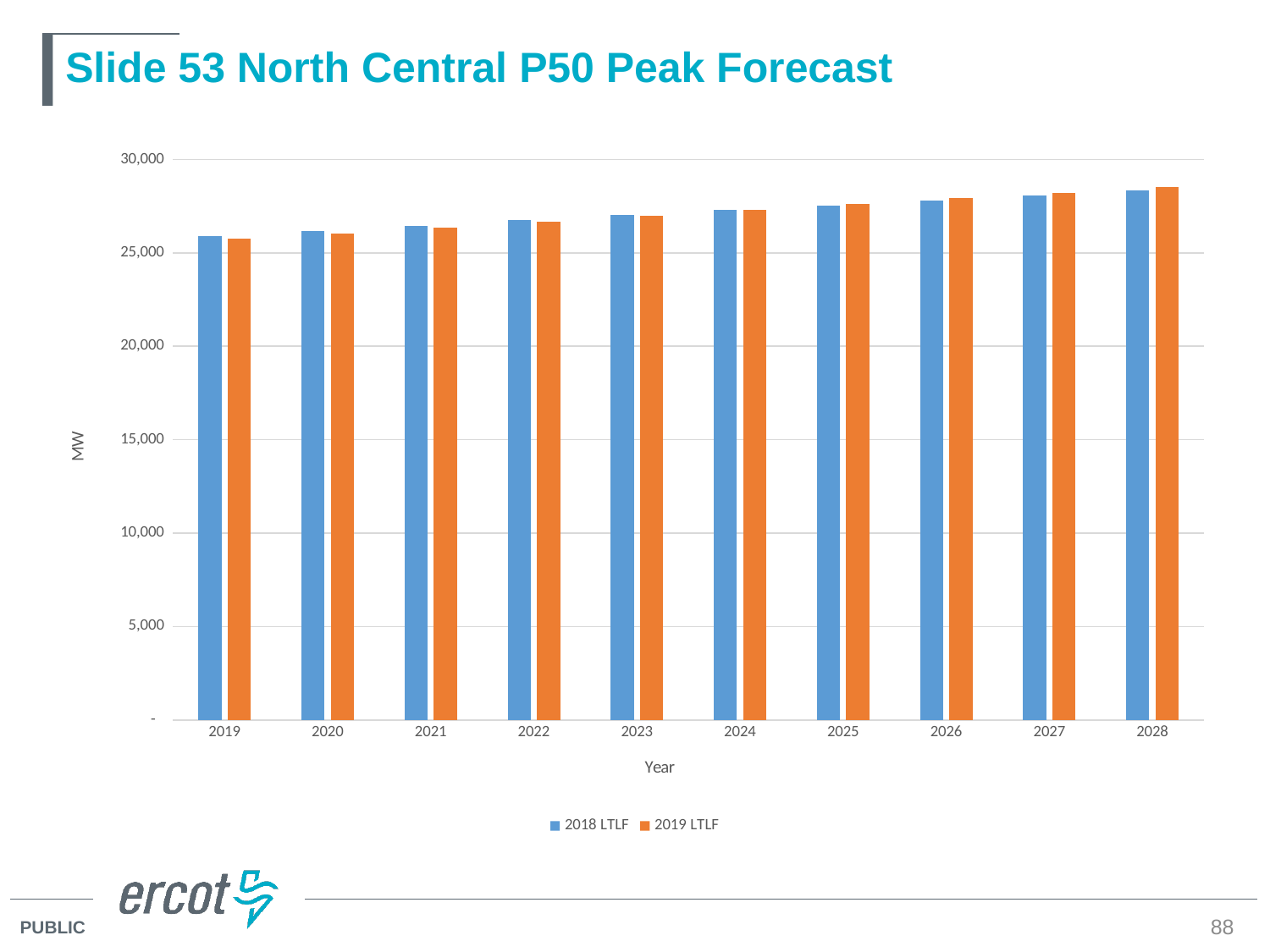
Do the 2018 LTLF values rise or fall across the years shown? Rise What kind of chart is shown on the slide? Bar chart How many series does the legend list? 2 Is the 2019 LTLF value for 2028 greater or less than 30,000? less Is the 2018 LTLF value for 2019 greater or less than 25,000? greater What is the label on the vertical axis? MW Which colour represents the 2019 LTLF series? Orange Which year has the lowest 2018 LTLF value? 2019 Which year has the highest 2019 LTLF value? 2028 How many years are shown on the x axis? 10 Do the 2019 LTLF values rise or fall from 2019 to 2028? Rise Is the 2019 LTLF value for 2024 greater or less than 20,000? greater